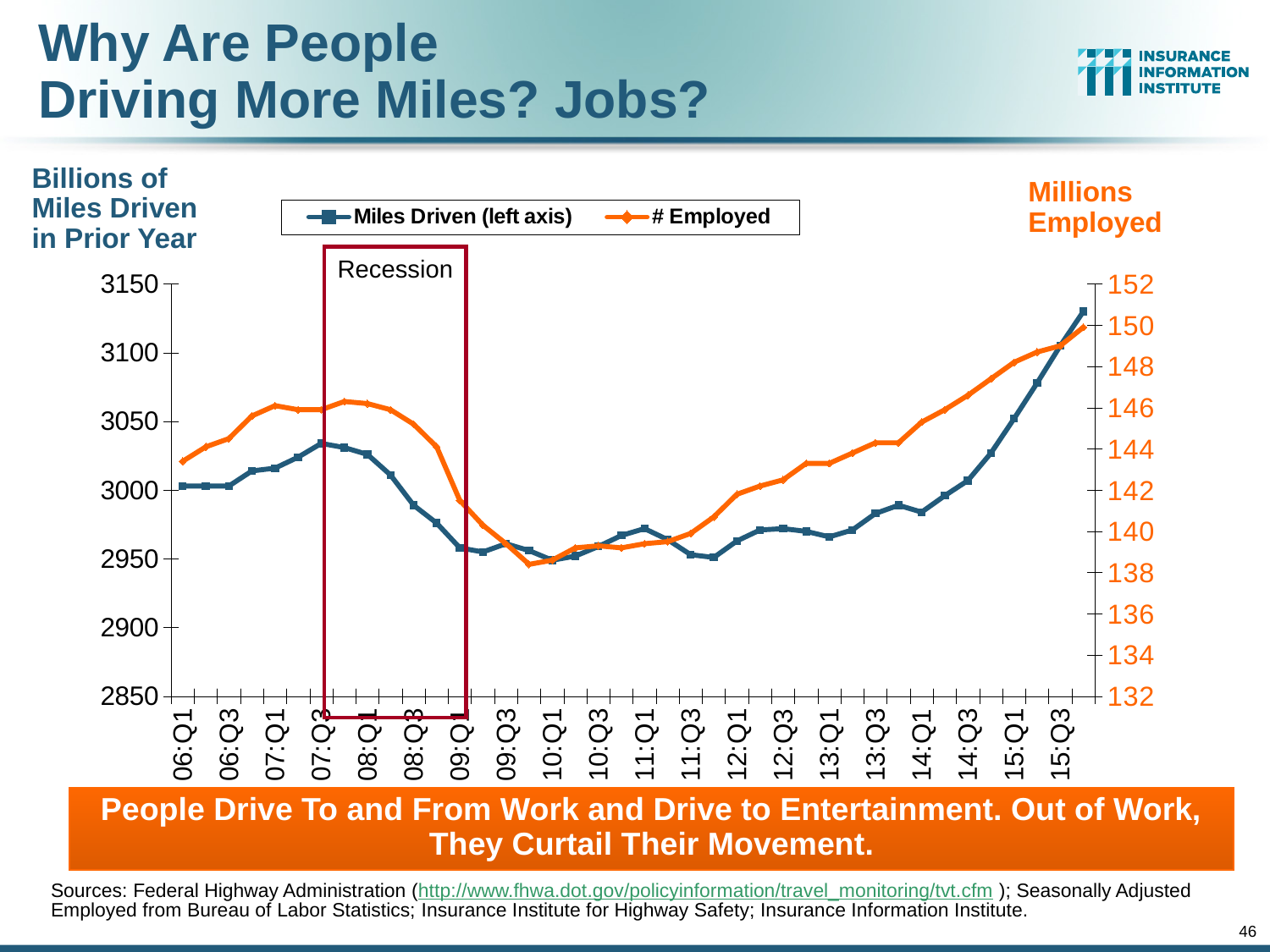
How many series does the chart's legend list? 2 Does the # Employed series rise or fall between 07:Q3 and 09:Q3? Fall Which series is plotted against the left axis according to the legend? Miles Driven Is the Miles Driven value at 09:Q1 greater or less than 3000? less Is the Miles Driven value at 07:Q3 greater or less than 3000? greater What label is shown inside the red box on the chart? Recession Is the # Employed value at 15:Q3 greater or less than 146? greater What kind of chart is shown on the slide? Line chart Which is larger, the Miles Driven value at 07:Q3 or at 09:Q1? 07:Q3 Does the Miles Driven series rise or fall between 13:Q1 and 15:Q3? Rise